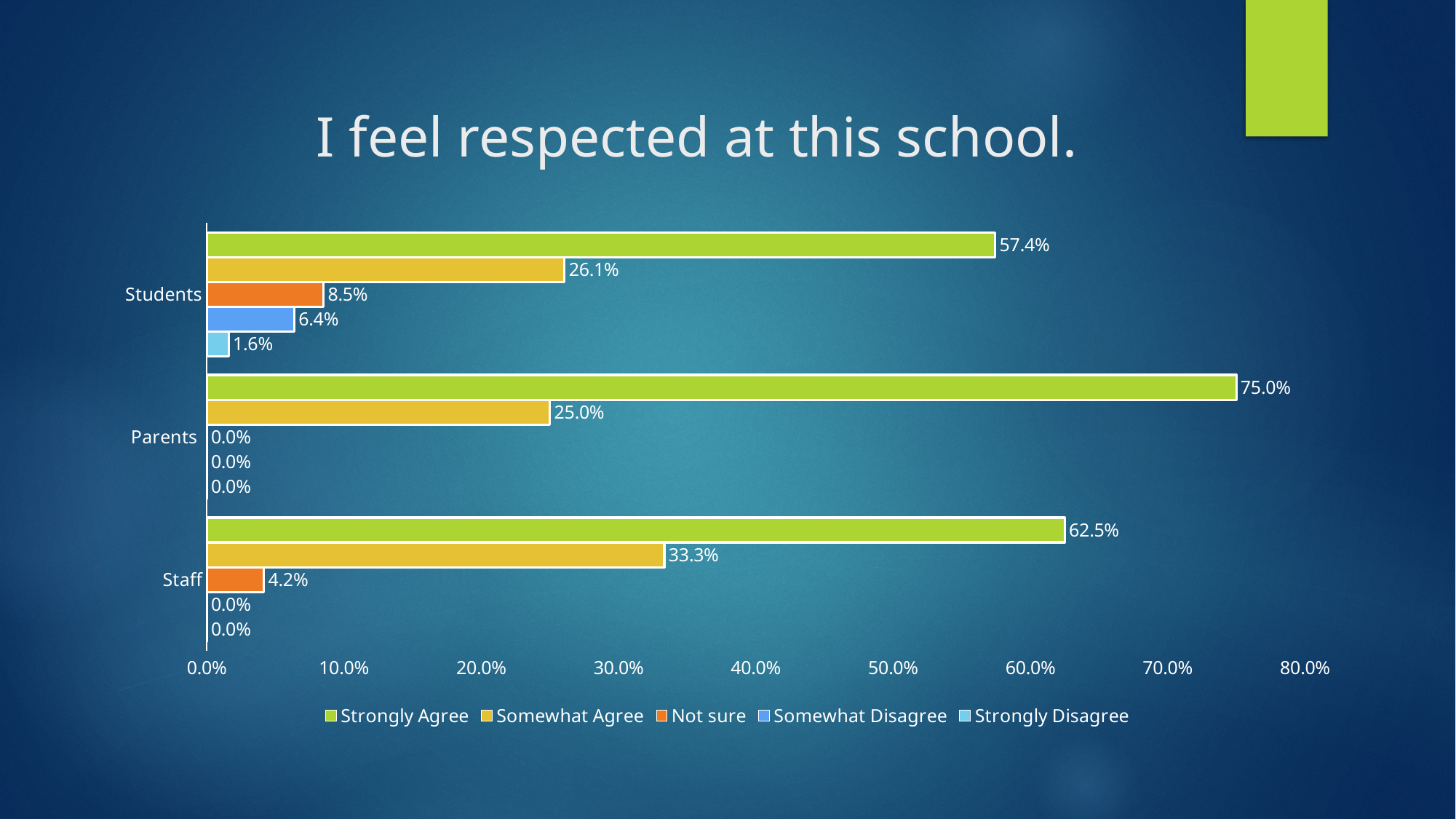
What percentage of Students responded Strongly Disagree? 1.6% Which group has the highest Strongly Agree percentage? Parents Which is larger: the Somewhat Agree percentage for Staff or for Students? Staff What percentage of Parents responded Somewhat Agree? 25.0% What percentage of Staff responded Not sure? 4.2% What is the difference between the Strongly Agree percentages for Parents and Staff? 12.5% Which group has the lowest Strongly Agree percentage? Students How many series does the legend list? 5 What percentage of Students responded Strongly Agree? 57.4% What kind of chart is shown on the slide? Bar chart What is the title of the chart? I feel respected at this school. How many groups are shown on the y axis? 3